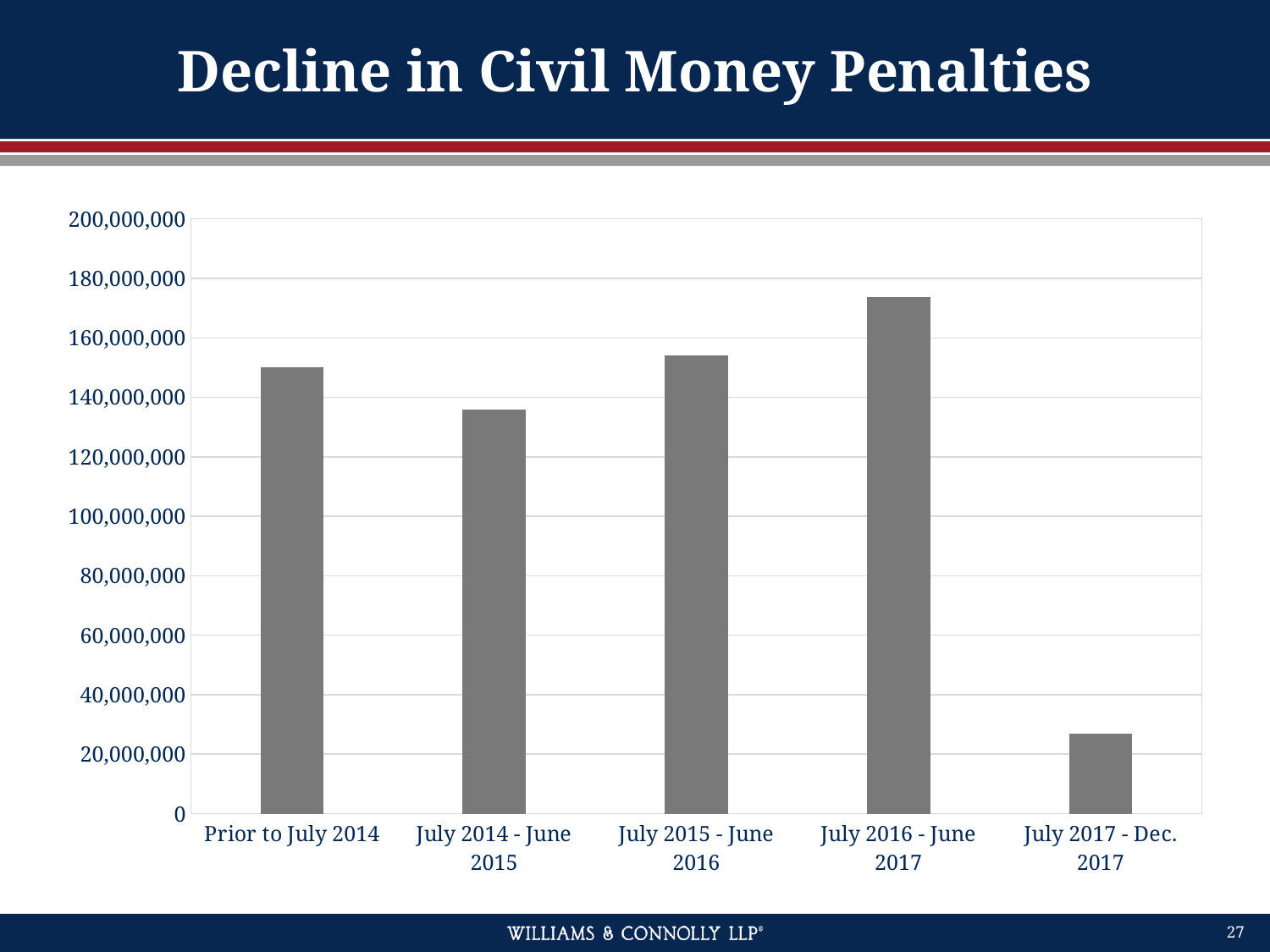
Which period has the lowest value on the chart? July 2017 - Dec. 2017 Is the value for July 2017 - Dec. 2017 greater or less than 40,000,000? less What is the highest value shown on the vertical axis of the chart? 200,000,000 Which is larger, the value for July 2016 - June 2017 or the value for July 2015 - June 2016? July 2016 - June 2017 What is the title of the slide containing the chart? Decline in Civil Money Penalties Is the value for July 2016 - June 2017 greater or less than 160,000,000? greater Is the value for July 2014 - June 2015 greater or less than 140,000,000? less Which period has the highest value on the chart? July 2016 - June 2017 What kind of chart is shown on the slide? Bar chart How many time periods (bars) are shown on the chart? 5 Which is larger, the value for Prior to July 2014 or the value for July 2014 - June 2015? Prior to July 2014